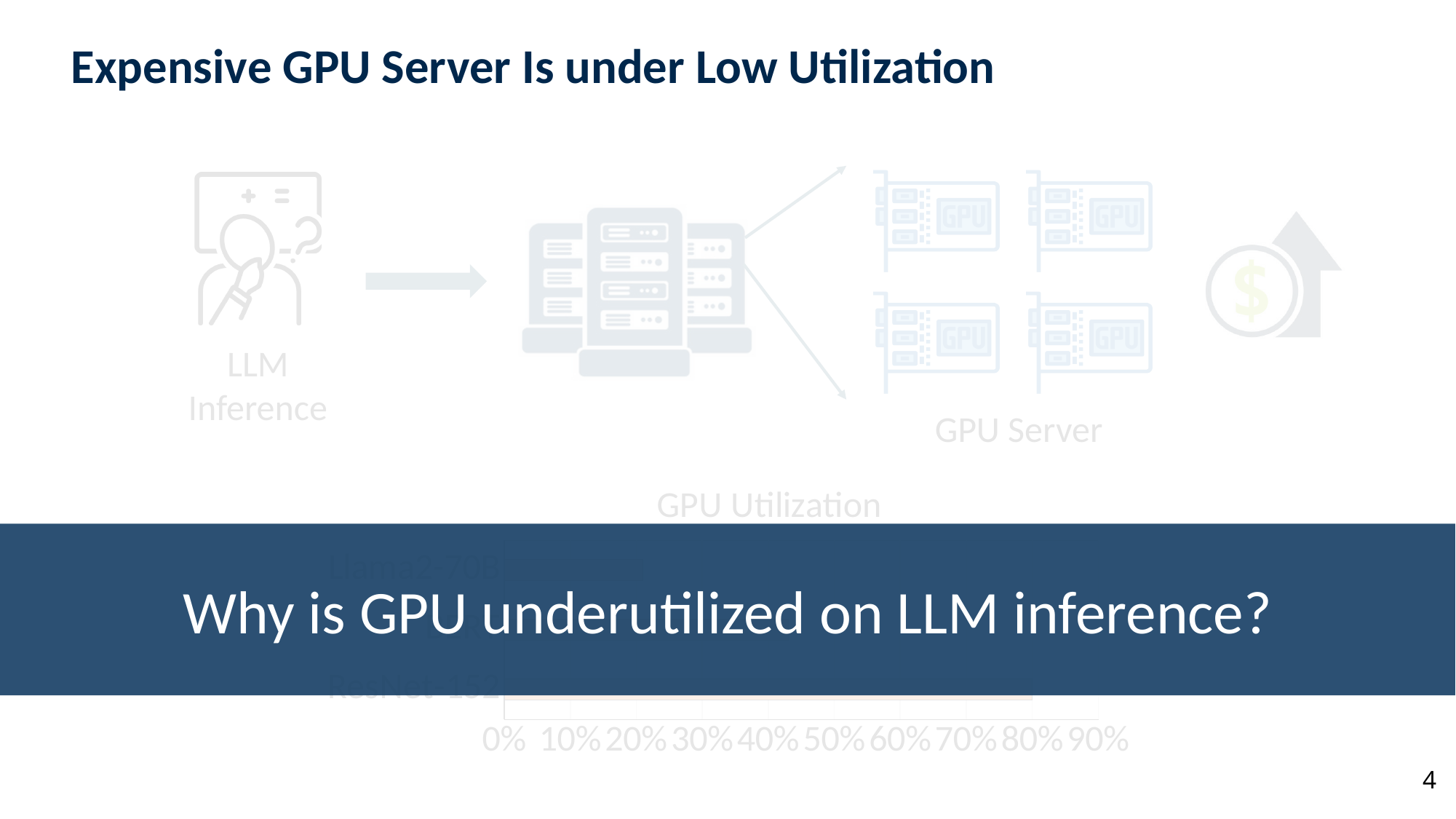
What is the highest tick label shown on the x axis of the GPU Utilization chart? 90% In the GPU Utilization chart, is the value for Llama2-70B greater or less than 40%? less In the GPU Utilization chart, is the value for ResNet-152 greater or less than 50%? greater In the GPU Utilization chart, is the value for Llama2-70B greater or less than 50%? less What is the title of the chart at the bottom of the slide? GPU Utilization What kind of chart is the GPU Utilization chart? bar chart In the GPU Utilization chart, which has the higher GPU utilization, Llama2-70B or ResNet-152? ResNet-152